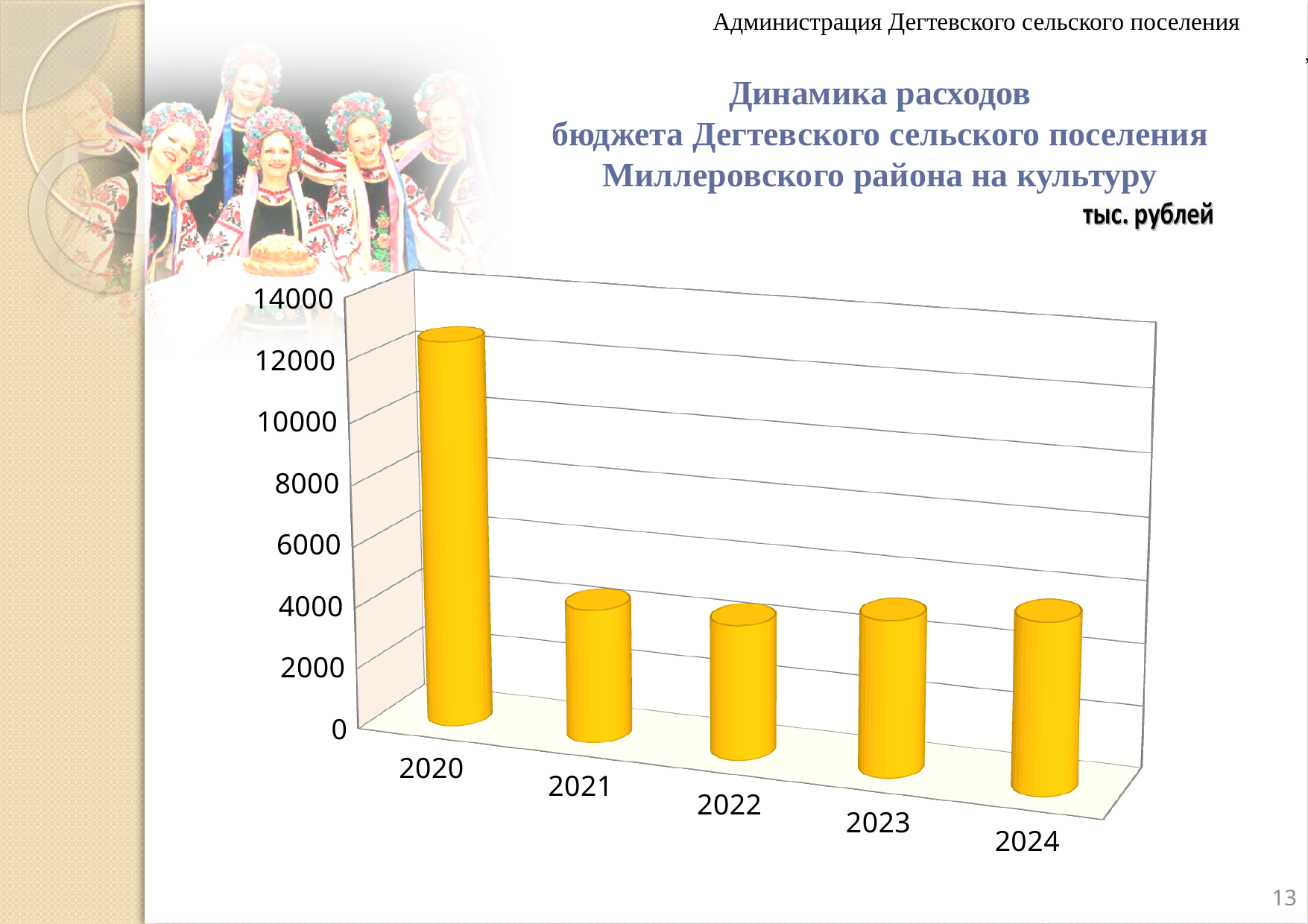
How many years are shown on the x axis of the chart? 5 Is the value for 2024 greater or less than 8000? less Which is larger, the value for 2020 or the value for 2021? 2020 Does the value rise or fall from 2020 to 2021? fall Is the value for 2023 greater or less than 2000? greater In what units are the values on the chart expressed, according to the slide? тыс. рублей What is the highest tick value shown on the vertical axis of the chart? 14000 Is the value for 2020 greater or less than 10000? greater Which year has the highest expenditure on culture in the chart? 2020 What kind of chart is shown on the slide? bar chart